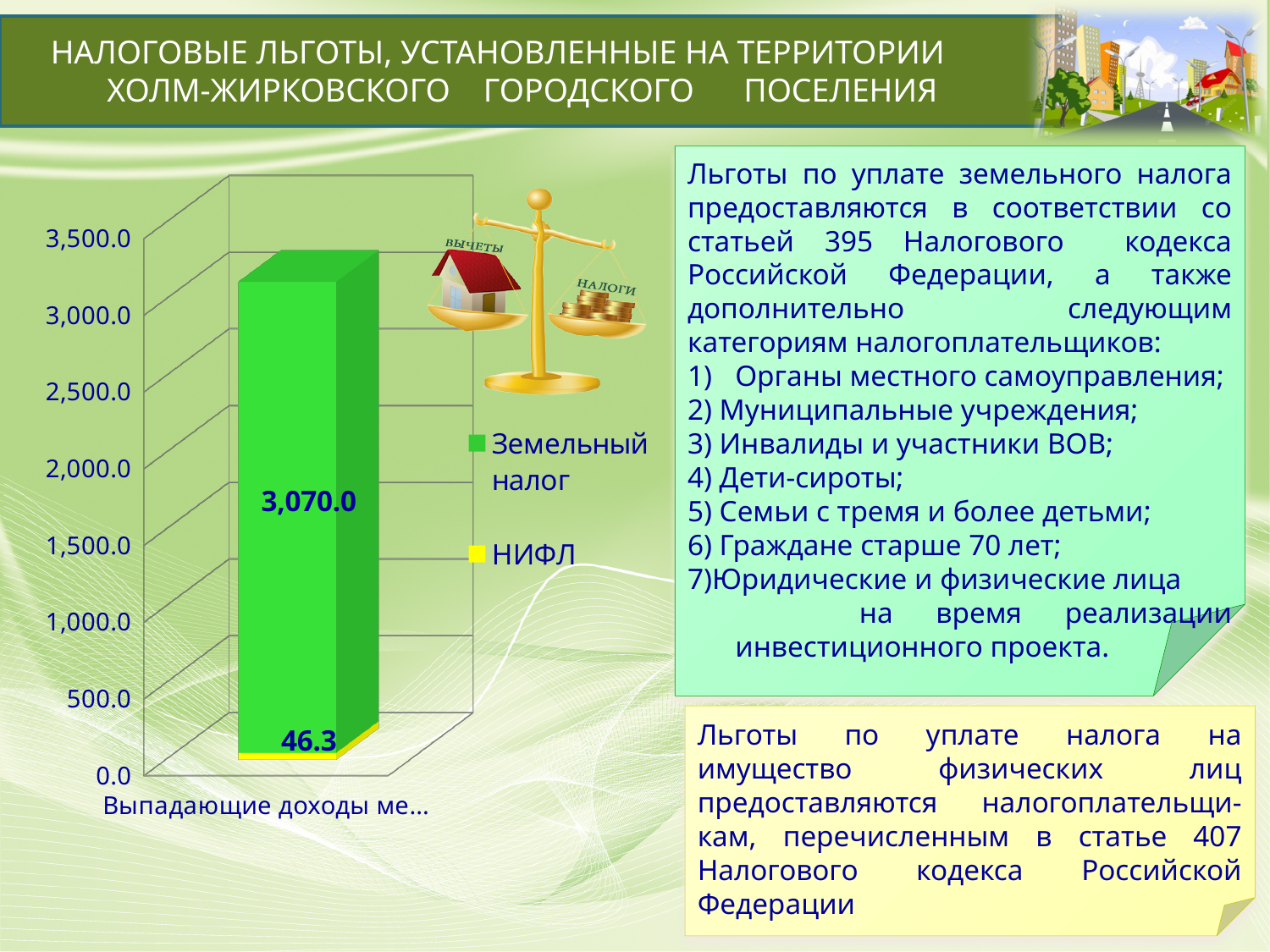
Which series has the larger value, Земельный налог or НИФЛ? Земельный налог What colour represents Земельный налог in the chart legend? green What is the total of the stacked bar on the chart? 3,116.3 Which series has the smallest value on the chart? НИФЛ What kind of chart is shown on the slide? bar chart What is the value for НИФЛ on the chart? 46.3 What is the difference between the Земельный налог value and the НИФЛ value? 3,023.7 Is the value for Земельный налог greater or less than 3,000.0? greater Is the value for НИФЛ greater or less than 500.0? less How many series does the chart legend list? 2 What is the value for Земельный налог on the chart? 3,070.0 Which series has the largest value on the chart? Земельный налог